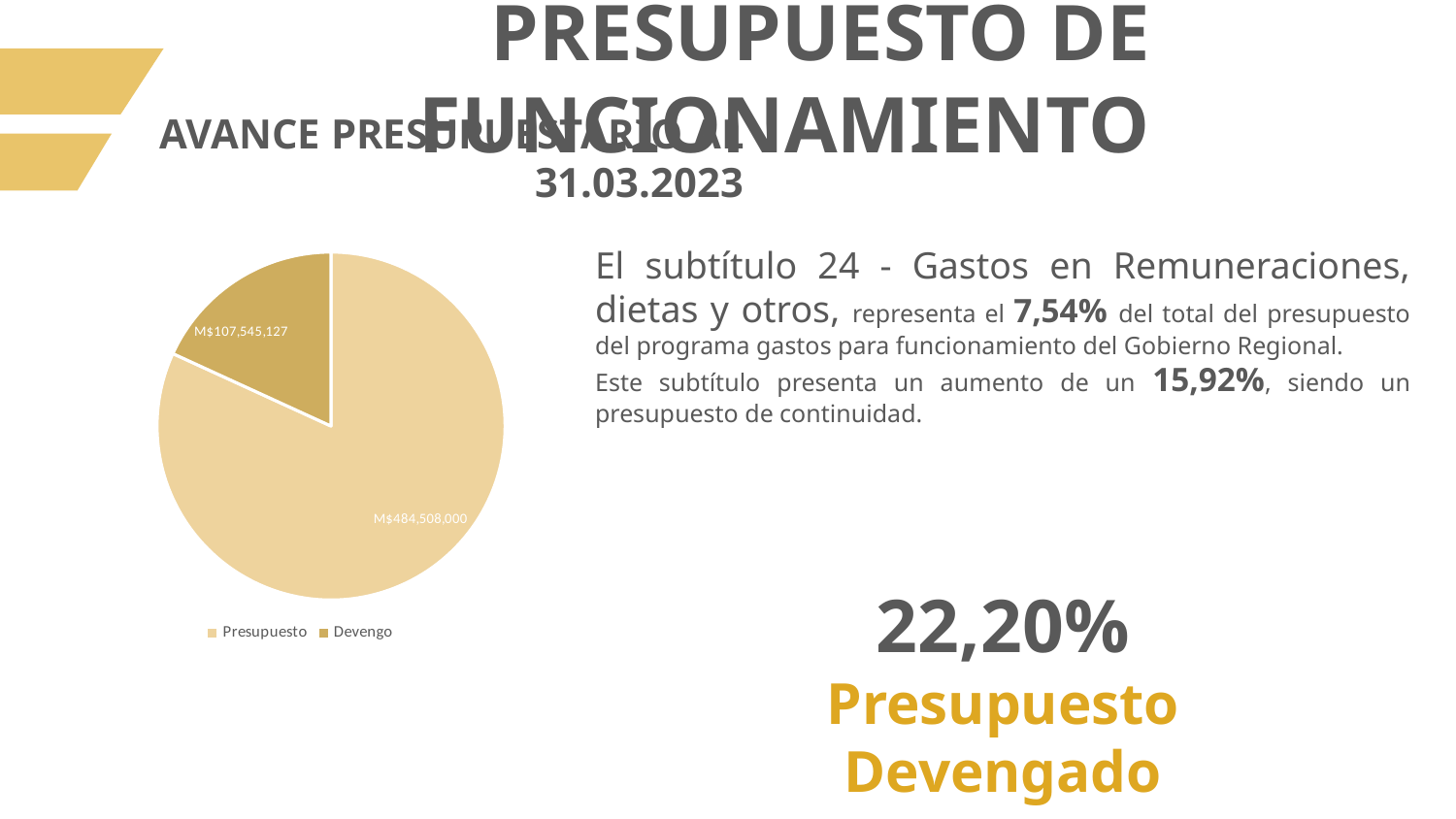
Which slice of the pie chart is the largest? Presupuesto Which slice of the pie chart is drawn in the darker gold colour? Devengo Which slice of the pie chart is the smallest? Devengo What value is shown for the Devengo slice of the pie chart? M$107,545,127 What is the total of the two values shown in the pie chart? M$592,053,127 Which is larger in the pie chart, Presupuesto or Devengo? Presupuesto What are the two entries listed in the pie chart's legend? Presupuesto and Devengo What kind of chart is shown on the slide? Pie chart What value is shown for the Presupuesto slice of the pie chart? M$484,508,000 How many entries does the pie chart's legend list? 2 How many slices does the pie chart have? 2 What is the difference between the Presupuesto value and the Devengo value in the pie chart? M$376,962,873